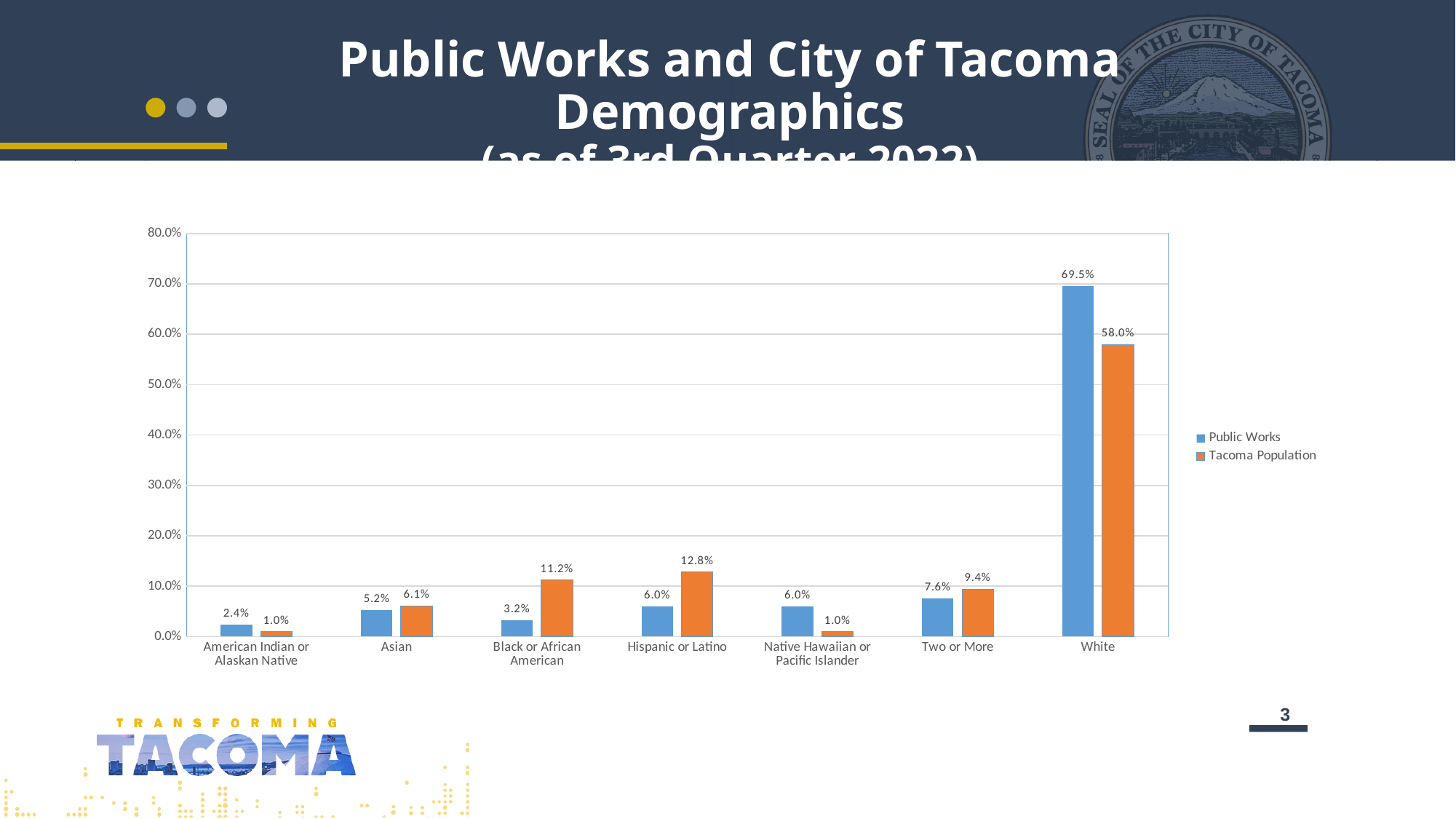
How many categories are shown on the x axis? 7 Which category has the highest Public Works value? White What is the Public Works value for Two or More? 7.6% Which is larger for Black or African American: the Public Works value or the Tacoma Population value? Tacoma Population Which category has the lowest Public Works value? American Indian or Alaskan Native What is the difference between the Public Works and Tacoma Population values for White? 11.5% What is the Public Works value for White? 69.5% Is the Tacoma Population value for White greater or less than 60.0%? less What is the Tacoma Population value for Hispanic or Latino? 12.8% What kind of chart is shown on the slide? bar chart What is the Tacoma Population value for Black or African American? 11.2% How many series does the legend list? 2